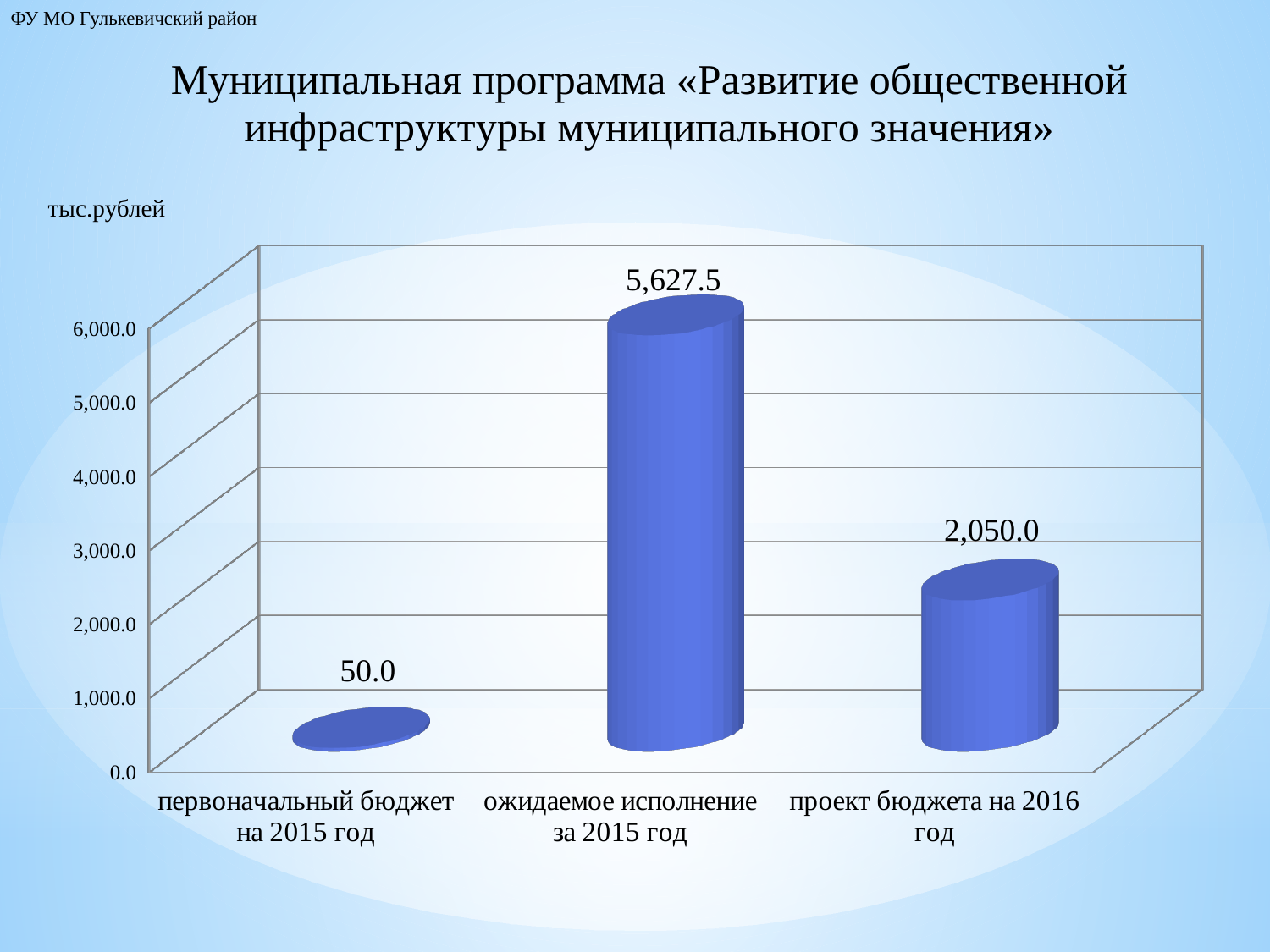
Which is larger: «проект бюджета на 2016 год» or «первоначальный бюджет на 2015 год»? проект бюджета на 2016 год Is the value for «проект бюджета на 2016 год» greater or less than 3,000.0? less What is the difference between «ожидаемое исполнение за 2015 год» and «проект бюджета на 2016 год»? 3,577.5 How many categories are shown on the chart? 3 What unit of measurement is indicated above the chart? тыс.рублей What is the value for «ожидаемое исполнение за 2015 год»? 5,627.5 What kind of chart is shown on the slide? bar chart What is the value for «проект бюджета на 2016 год»? 2,050.0 Which category has the highest value? ожидаемое исполнение за 2015 год What is the value for «первоначальный бюджет на 2015 год»? 50.0 Which category has the lowest value? первоначальный бюджет на 2015 год What is the difference between «проект бюджета на 2016 год» and «первоначальный бюджет на 2015 год»? 2,000.0